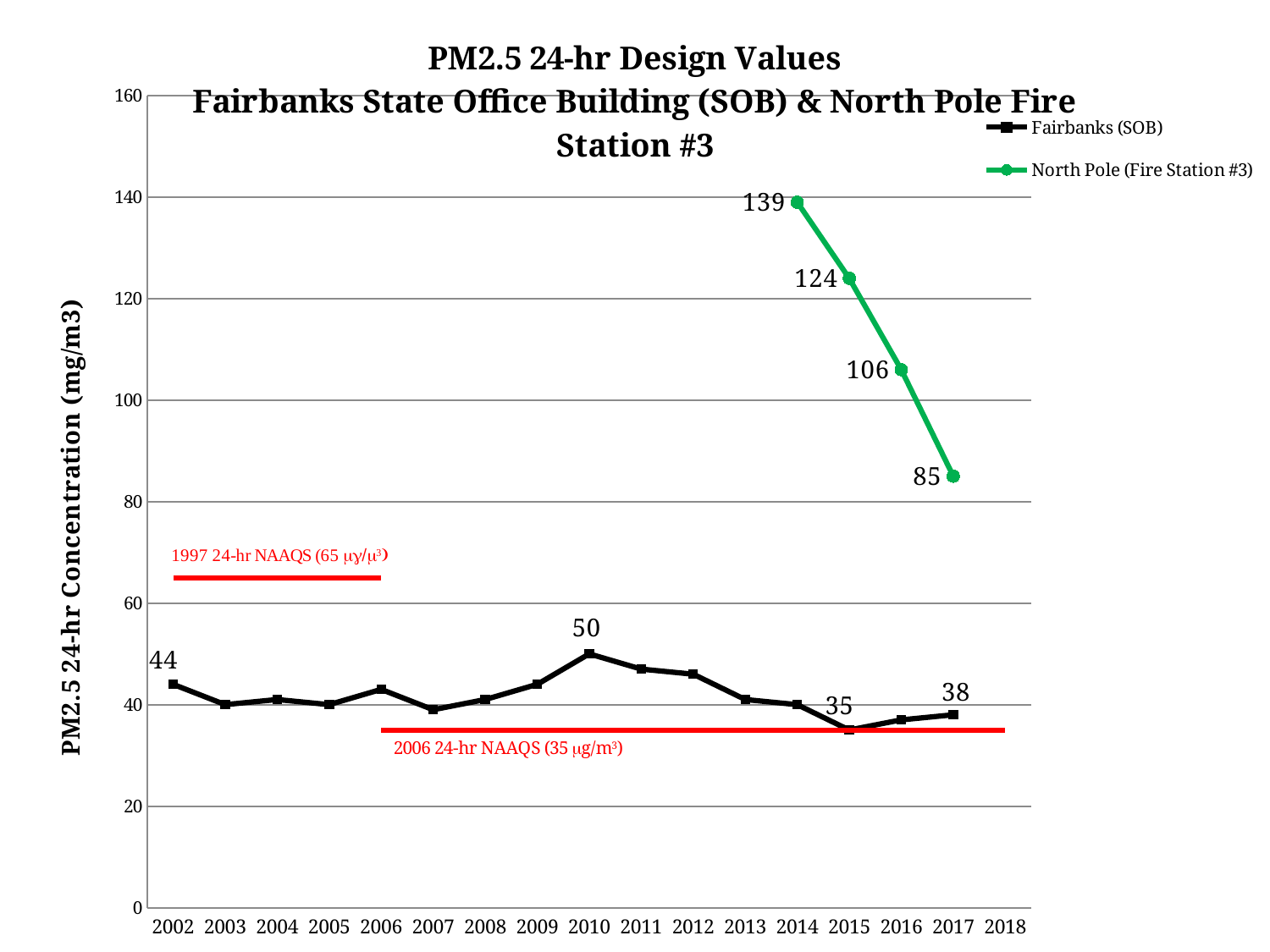
What is the North Pole (Fire Station #3) value for 2014? 139 How many series does the legend list? 2 What is the difference between the North Pole (Fire Station #3) values for 2014 and 2017? 54 What is the Fairbanks (SOB) value for 2015? 35 In which year is the North Pole (Fire Station #3) value highest? 2014 What is the difference between the Fairbanks (SOB) values for 2010 and 2015? 15 What is the Fairbanks (SOB) value for 2010? 50 Do the North Pole (Fire Station #3) values rise or fall from 2014 to 2017? fall Is the Fairbanks (SOB) value for 2012 greater or less than 60? less What kind of chart is shown on the slide? line chart In 2015, which series has the larger value, Fairbanks (SOB) or North Pole (Fire Station #3)? North Pole (Fire Station #3) What is the North Pole (Fire Station #3) value for 2017? 85